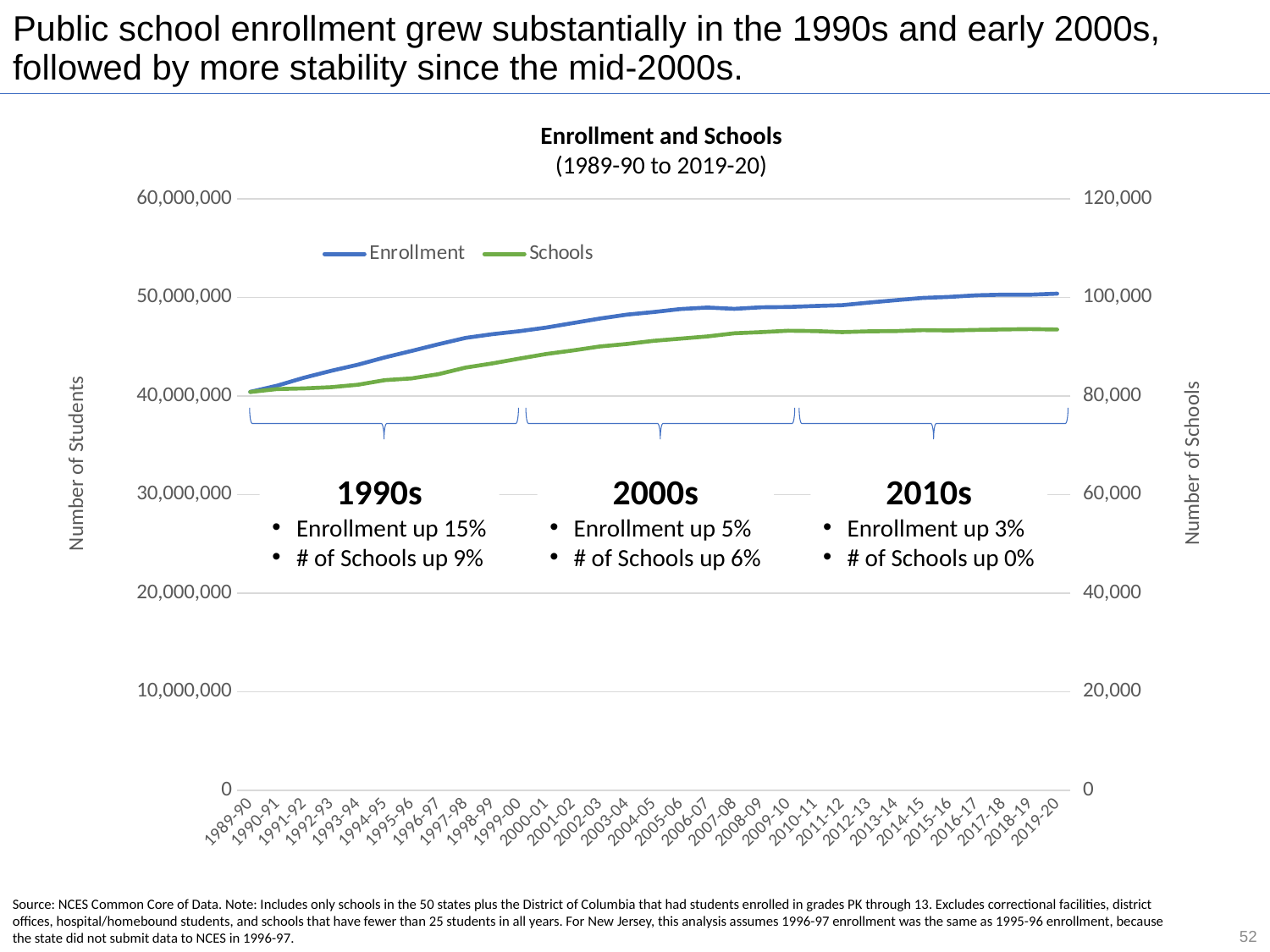
According to the annotation on the chart, by what percentage did enrollment go up in the 1990s? 15% Is the Enrollment value for 2019-20 greater or less than 40,000,000? greater According to the annotation on the chart, by what percentage did the number of schools go up in the 2010s? 0% What is the label of the right-hand vertical axis? Number of Schools Is the Schools value for 1989-90 greater or less than 100,000? less Does the Enrollment line generally rise or fall from 1989-90 to 2019-20? Rise Is the Enrollment value for 1989-90 greater or less than 50,000,000? less What kind of chart is shown on the slide? Line chart How many series does the legend list? 2 What are the two series named in the legend? Enrollment and Schools How many school years are plotted along the x axis? 31